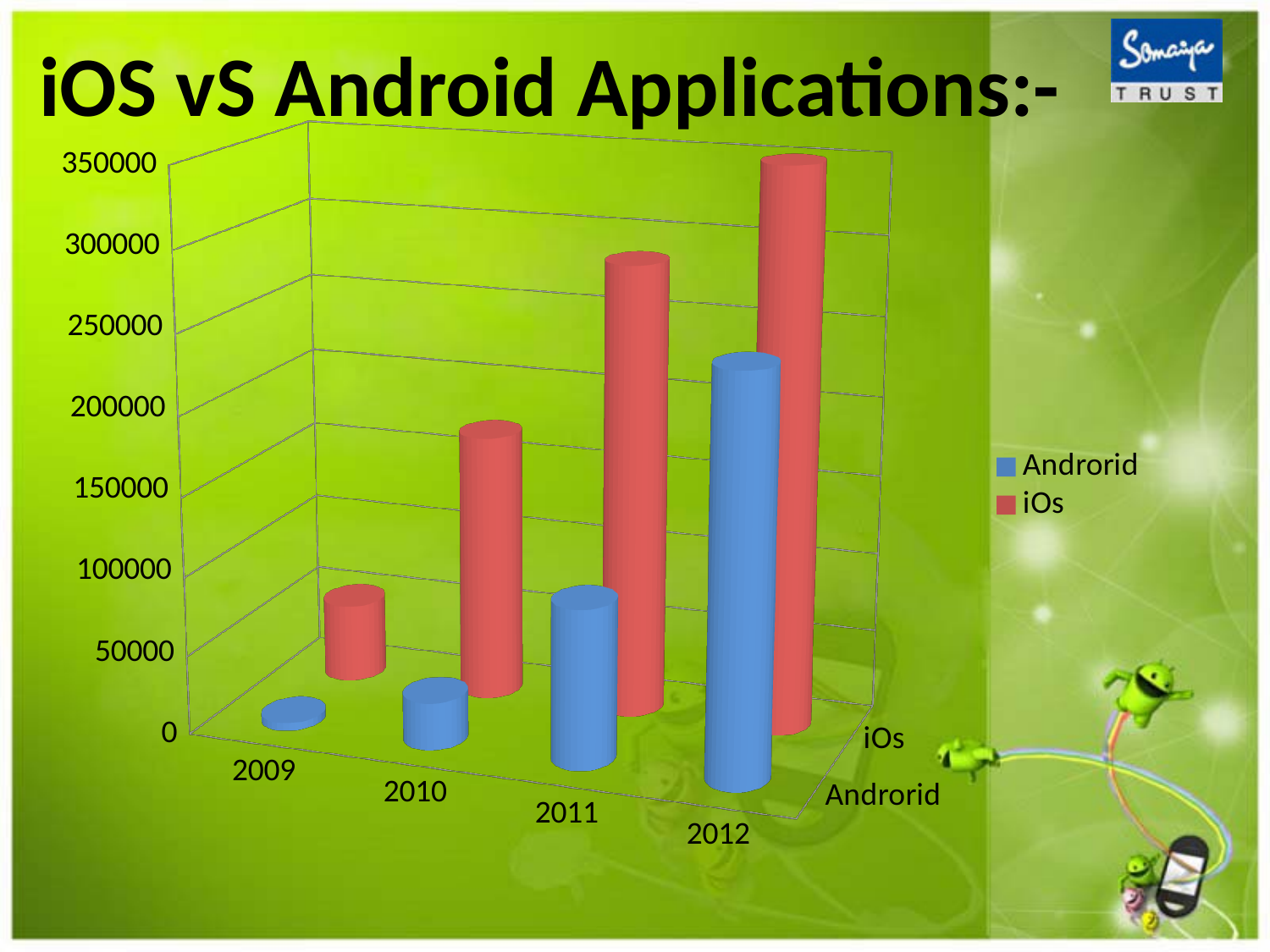
Which series is shown in blue? Androrid In 2012, which is larger, the iOs value or the Androrid value? iOs What is the title of the slide? iOS vS Android Applications:- In 2009, which is larger, the iOs value or the Androrid value? iOs Do the iOs values rise or fall from 2009 to 2012? rise Is the iOs value for 2012 greater or less than 250000? greater Is the Androrid value for 2009 greater or less than 50000? less What kind of chart is shown on the slide? bar chart Which year has the highest iOs value? 2012 How many series does the legend list? 2 Which year has the lowest Androrid value? 2009 How many years are shown on the x axis? 4